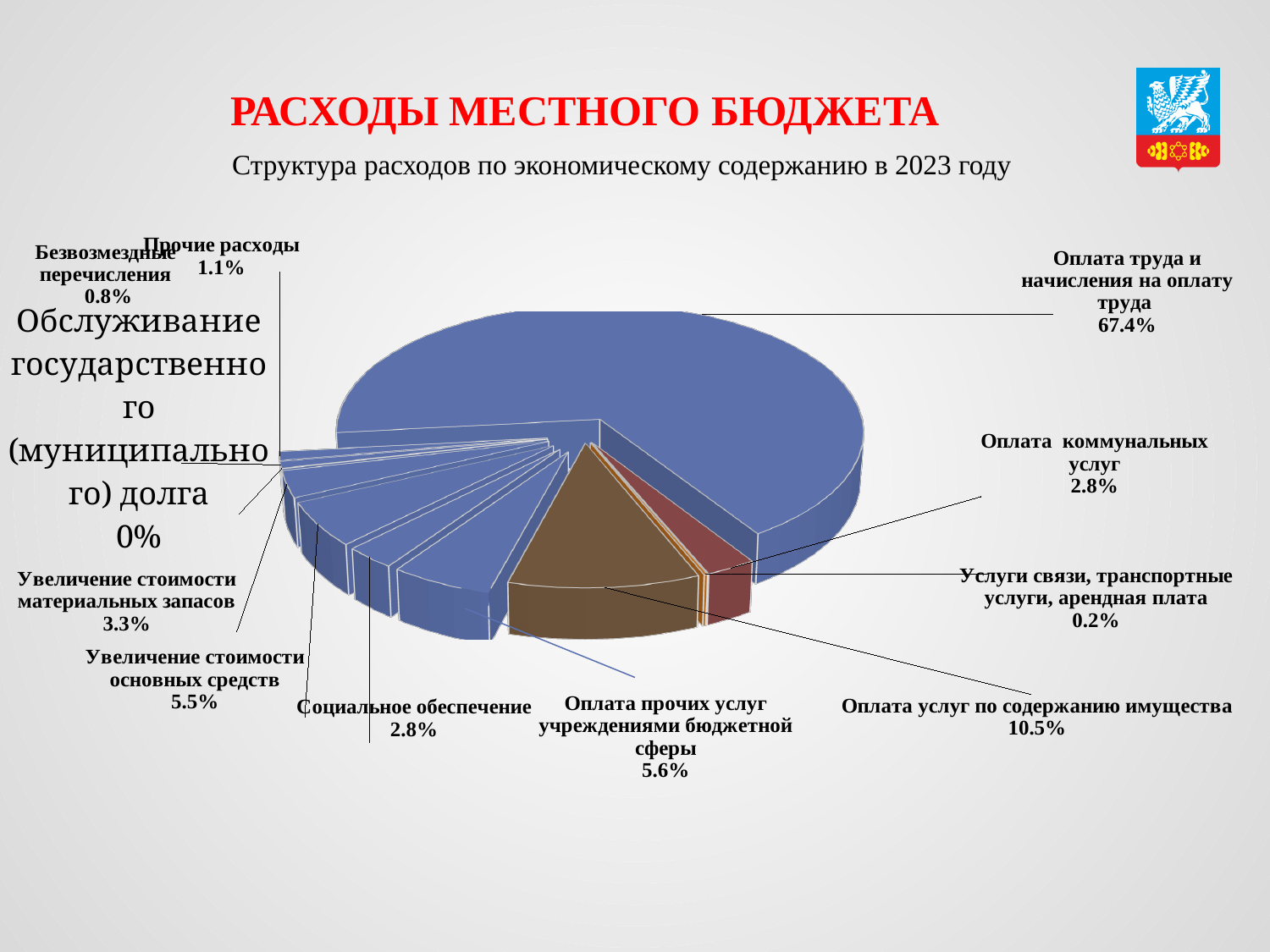
What percentage is shown for "Услуги связи, транспортные услуги, арендная плата"? 0.2% What kind of chart is shown on the slide? pie chart Which category has the largest share of the pie? Оплата труда и начисления на оплату труда What value is labelled for "Обслуживание государственного (муниципального) долга"? 0% Which is larger: the share for "Увеличение стоимости материальных запасов" or for "Прочие расходы"? Увеличение стоимости материальных запасов Which category has the smallest labelled share? Обслуживание государственного (муниципального) долга What value is labelled for "Увеличение стоимости основных средств"? 5.5% How many categories are labelled on the pie chart? 11 What is the difference between the shares for "Оплата услуг по содержанию имущества" and "Оплата прочих услуг учреждениями бюджетной сферы"? 4.9% What year does the chart subtitle say the expenditure structure refers to? 2023 What share of expenditures is labelled for "Оплата труда и начисления на оплату труда"? 67.4% What percentage is shown for "Оплата услуг по содержанию имущества"? 10.5%